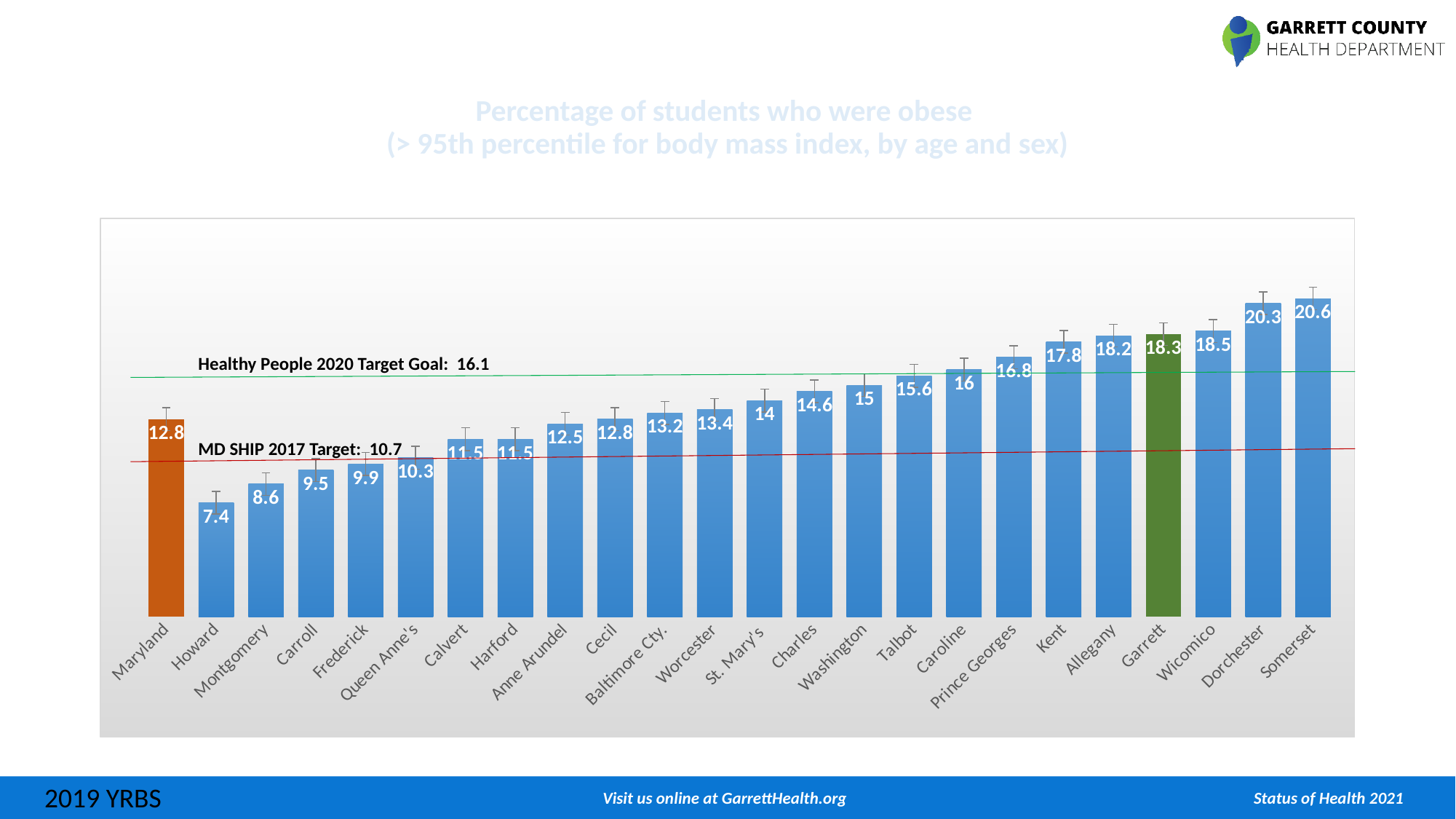
What is the MD SHIP 2017 Target shown on the chart? 10.7 Do the values generally rise or fall from left to right after the Maryland bar? Rise What is the value for Prince Georges? 16.8 What is the Healthy People 2020 Target Goal shown on the chart? 16.1 Which county has the highest percentage of students who were obese? Somerset What is the difference between the values for Garrett and Maryland? 5.5 Which county has the lowest percentage of students who were obese? Howard What kind of chart is shown on the slide? Bar chart Which is larger, the value for Dorchester or the value for Kent? Dorchester What is the value for Maryland? 12.8 What is the value for Garrett? 18.3 How many bars are plotted in the chart? 24